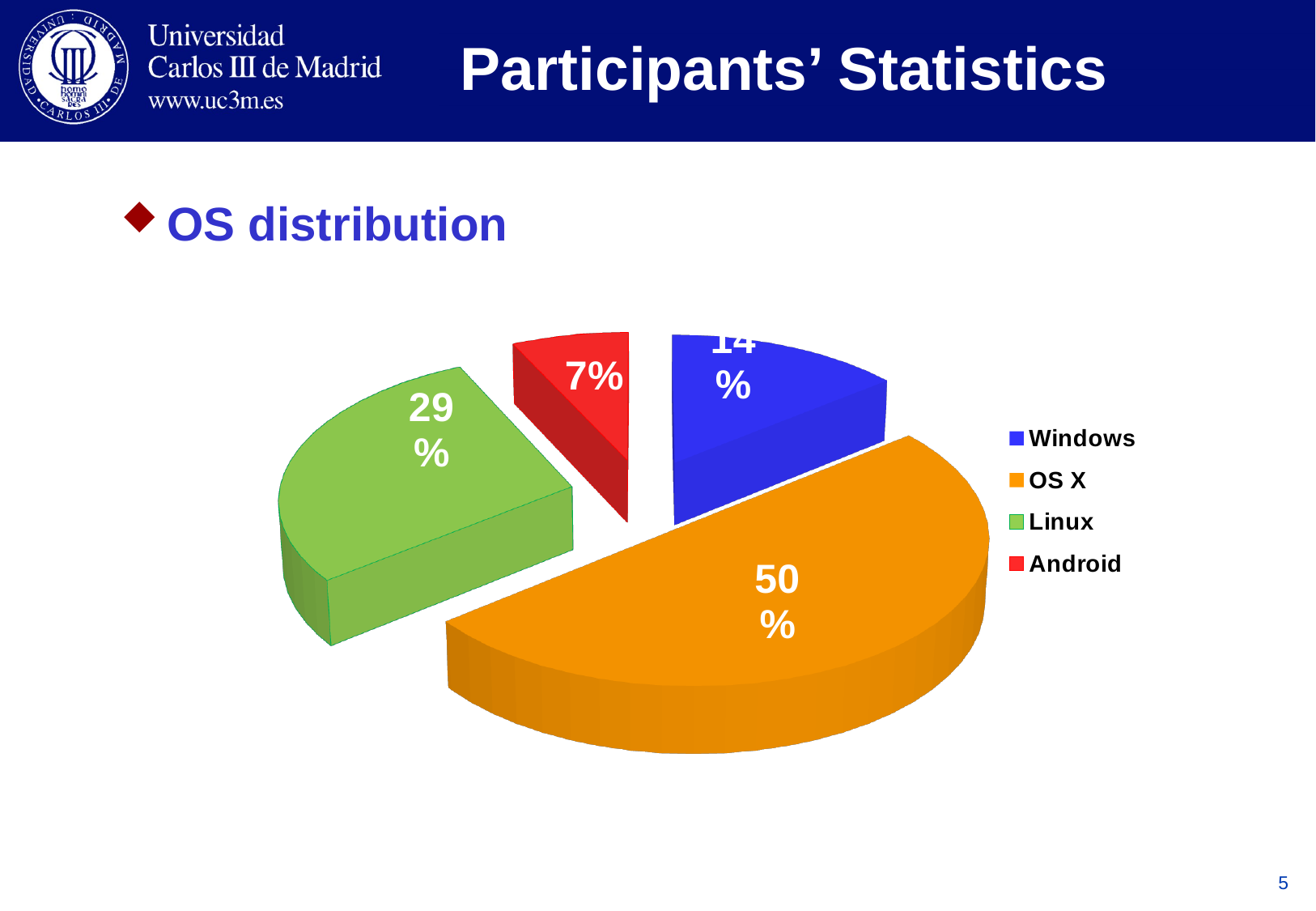
What kind of chart is used to show the OS distribution? Pie chart How many operating systems are shown in the pie chart? 4 Which has a larger share, Linux or Windows? Linux What share of participants use Windows? 14% Which operating system has the smallest share of participants? Android Which operating system has the largest share of participants? OS X What share of participants use Android? 7% What is the difference in percentage points between the Windows share and the Android share? 7 What colour represents Linux in the pie chart? Green What share of participants use Linux? 29% What is the difference in percentage points between the OS X share and the Linux share? 21 What share of participants use OS X? 50%